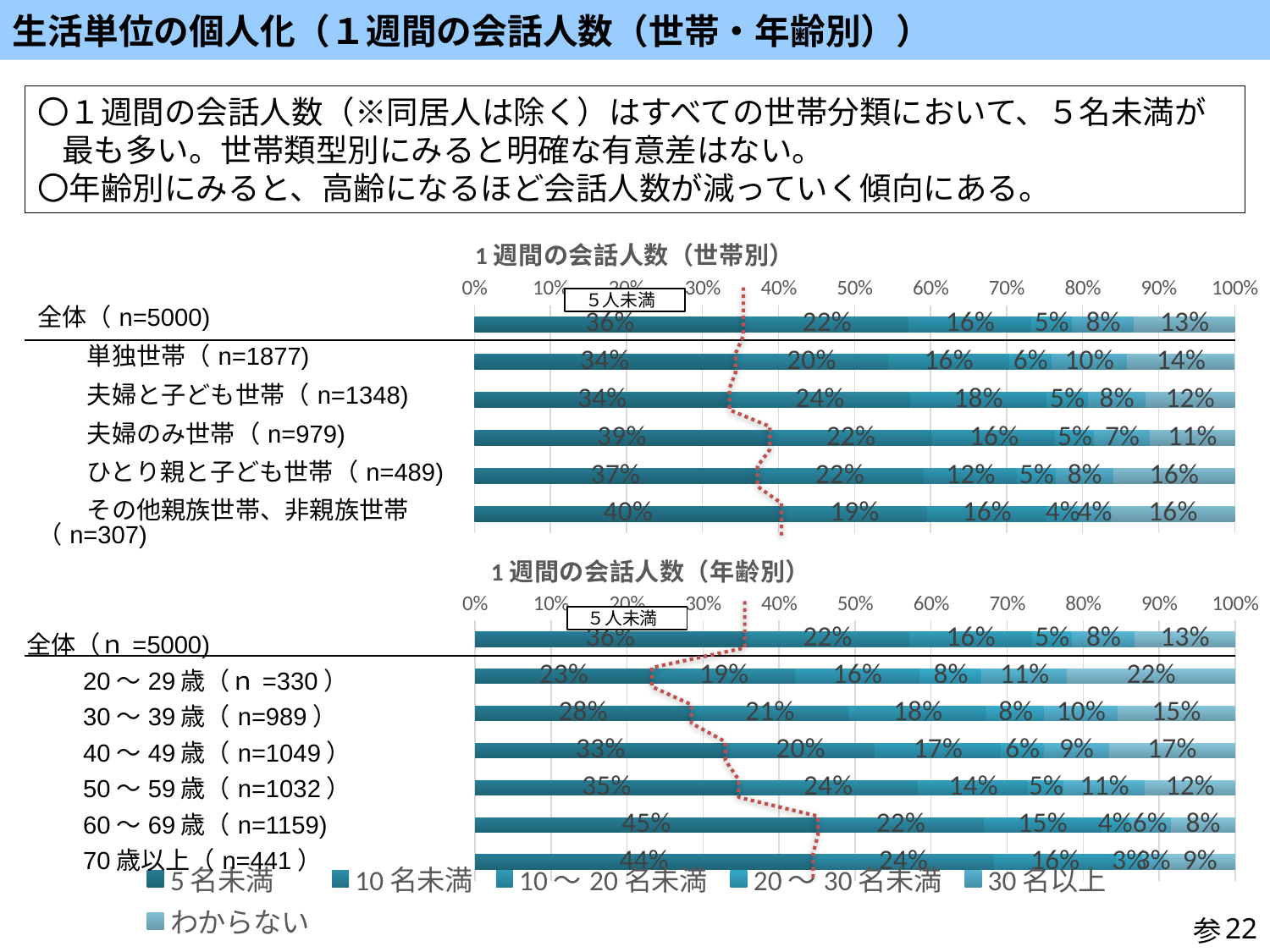
In the chart titled 1週間の会話人数（世帯別）, which household category has the highest 5名未満 share? その他親族世帯、非親族世帯 In the chart titled 1週間の会話人数（世帯別）, what is the value of 5名未満 for 夫婦のみ世帯? 39% In the chart titled 1週間の会話人数（世帯別）, what is the difference between the 5名未満 values for 夫婦のみ世帯 and 単独世帯? 5% How many series does the legend list for the charts on this slide? 6 In the chart titled 1週間の会話人数（世帯別）, what is the value of わからない for ひとり親と子ども世帯? 16% In the chart titled 1週間の会話人数（年齢別）, what is the value of 10名未満 for 50～59歳? 24% How many age-group rows (excluding 全体) are shown in the chart titled 1週間の会話人数（年齢別）? 6 What kind of chart is 1週間の会話人数（世帯別）? Stacked bar chart In the chart titled 1週間の会話人数（年齢別）, does the 5名未満 share generally rise or fall as age increases from 20～29歳 to 60～69歳? rise In the chart titled 1週間の会話人数（年齢別）, what is the value of 5名未満 for 60～69歳? 45% In the chart titled 1週間の会話人数（年齢別）, which age group has the lowest 5名未満 share? 20～29歳 In the chart titled 1週間の会話人数（年齢別）, which is larger: the わからない value for 20～29歳 or for 60～69歳? 20～29歳